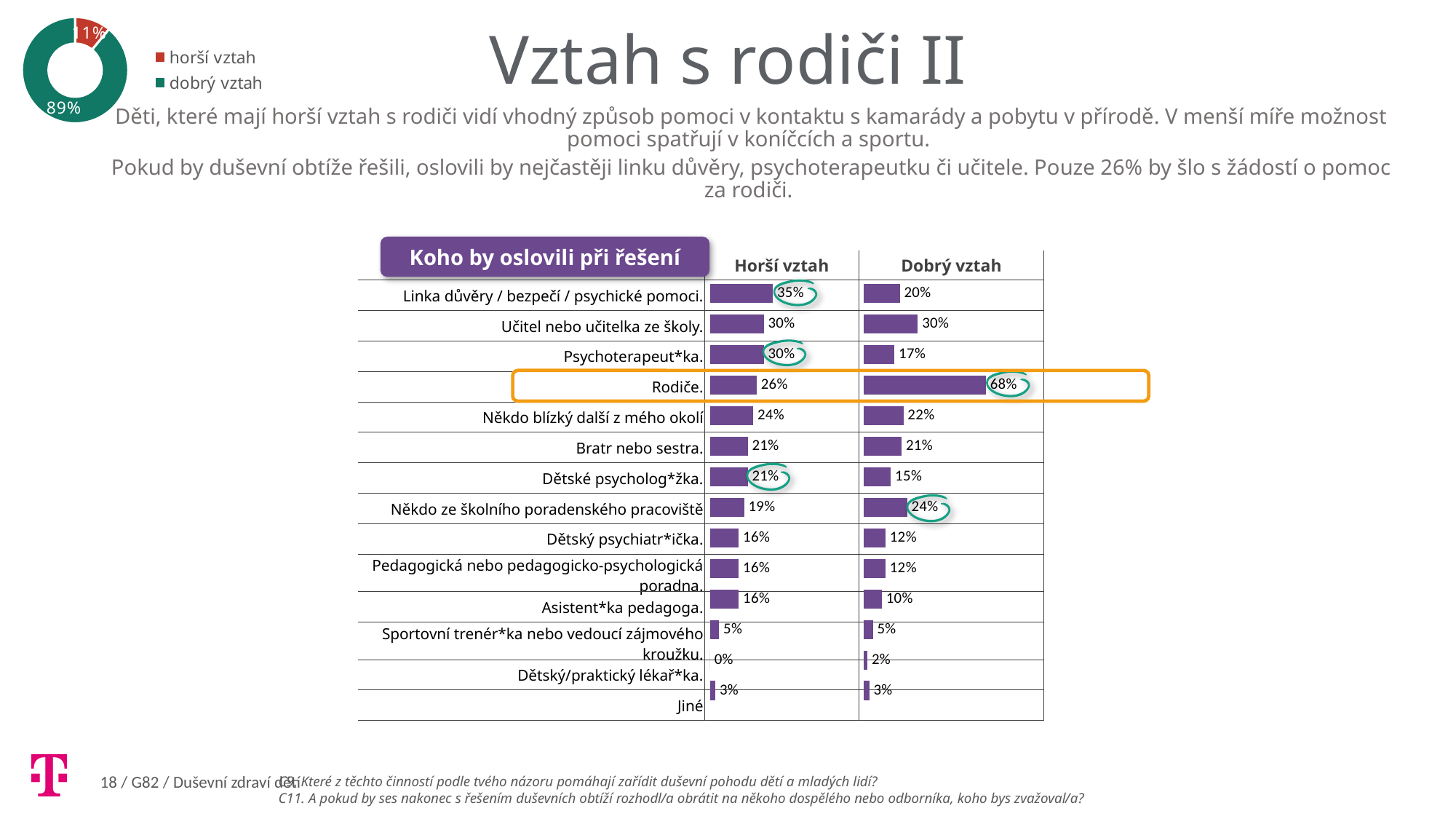
How many entries does the legend of the small donut chart in the top-left corner list? 2 In the 'Koho by oslovili při řešení' chart, which is larger for Někdo ze školního poradenského pracoviště: the Horší vztah value or the Dobrý vztah value? Dobrý vztah In the 'Koho by oslovili při řešení' chart, which category has the highest value in the Horší vztah column? Linka důvěry / bezpečí / psychické pomoci. In the 'Koho by oslovili při řešení' chart, what is the value for Rodiče in the Dobrý vztah column? 68% What kind of chart is the 'Koho by oslovili při řešení' chart? Bar chart In the 'Koho by oslovili při řešení' chart, what is the difference between the Dobrý vztah and Horší vztah values for Rodiče? 42 percentage points In the 'Koho by oslovili při řešení' chart, which category has the lowest value in the Horší vztah column? Dětský/praktický lékař*ka. In the small donut chart in the top-left corner, what is the share for dobrý vztah? 89% In the 'Koho by oslovili při řešení' chart, what is the value for Psychoterapeut*ka in the Dobrý vztah column? 17% In the 'Koho by oslovili při řešení' chart, which is larger for Dětské psycholog*žka: the Horší vztah value or the Dobrý vztah value? Horší vztah In the 'Koho by oslovili při řešení' chart, what is the value for Linka důvěry / bezpečí / psychické pomoci in the Horší vztah column? 35% How many categories are listed in the 'Koho by oslovili při řešení' chart? 14